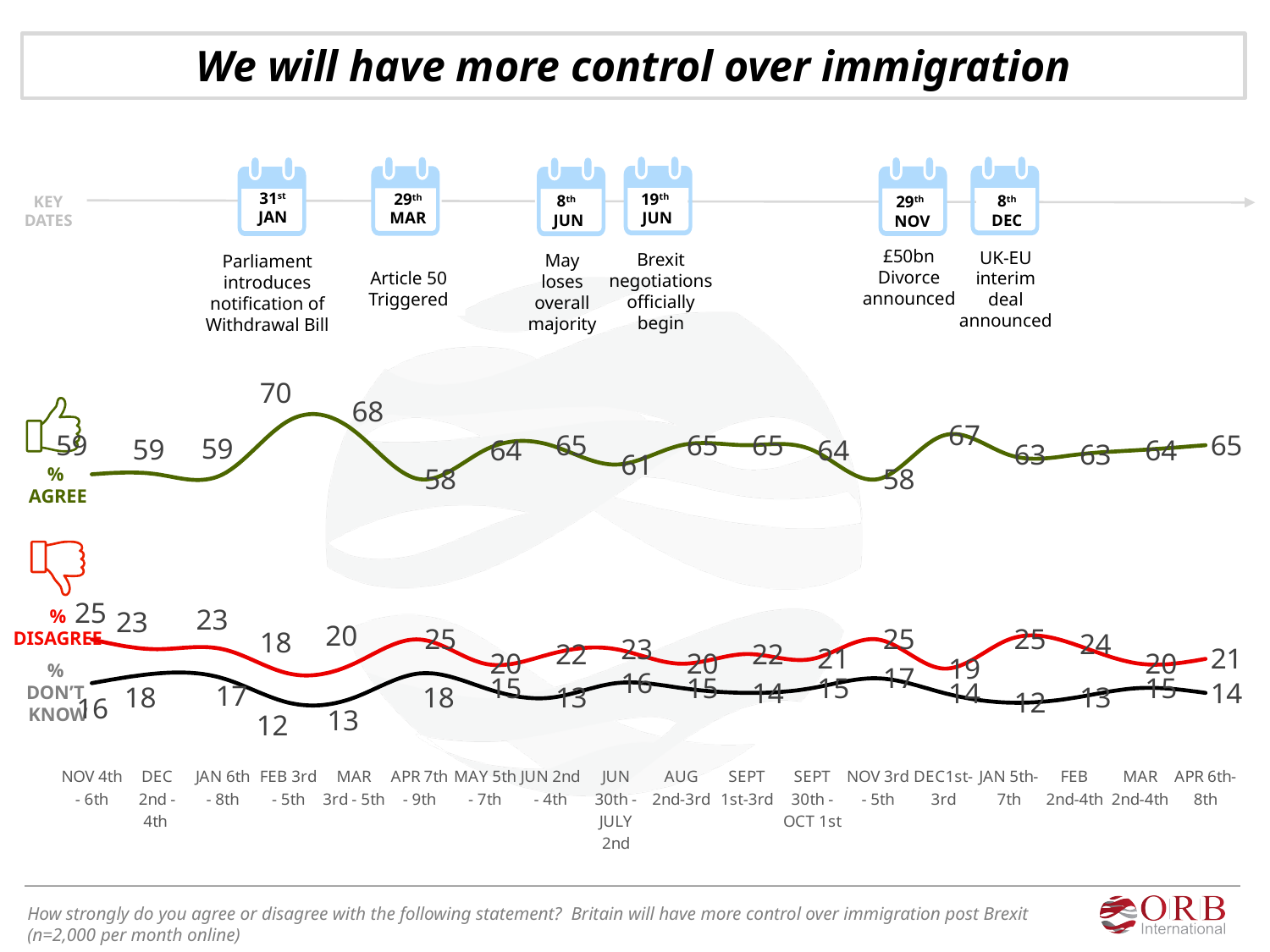
What is the % DON'T KNOW value for NOV 4th - 6th? 16 Which has the higher % AGREE value, DEC 1st - 3rd or JAN 5th - 7th? DEC 1st - 3rd How many survey periods are shown on the x axis? 18 What is the % DISAGREE value for APR 6th - 8th? 21 How many series are plotted on the chart? 3 What is the % AGREE value for MAR 3rd - 5th? 68 What kind of chart is shown on the slide? Line chart In which survey period is the % AGREE value highest? FEB 3rd - 5th What is the % AGREE value for FEB 3rd - 5th? 70 In which survey period is the % DISAGREE value lowest? FEB 3rd - 5th What is the difference between the % DISAGREE values for APR 7th - 9th and MAY 5th - 7th? 5 What is the difference between the % AGREE values for FEB 3rd - 5th and MAR 3rd - 5th? 2